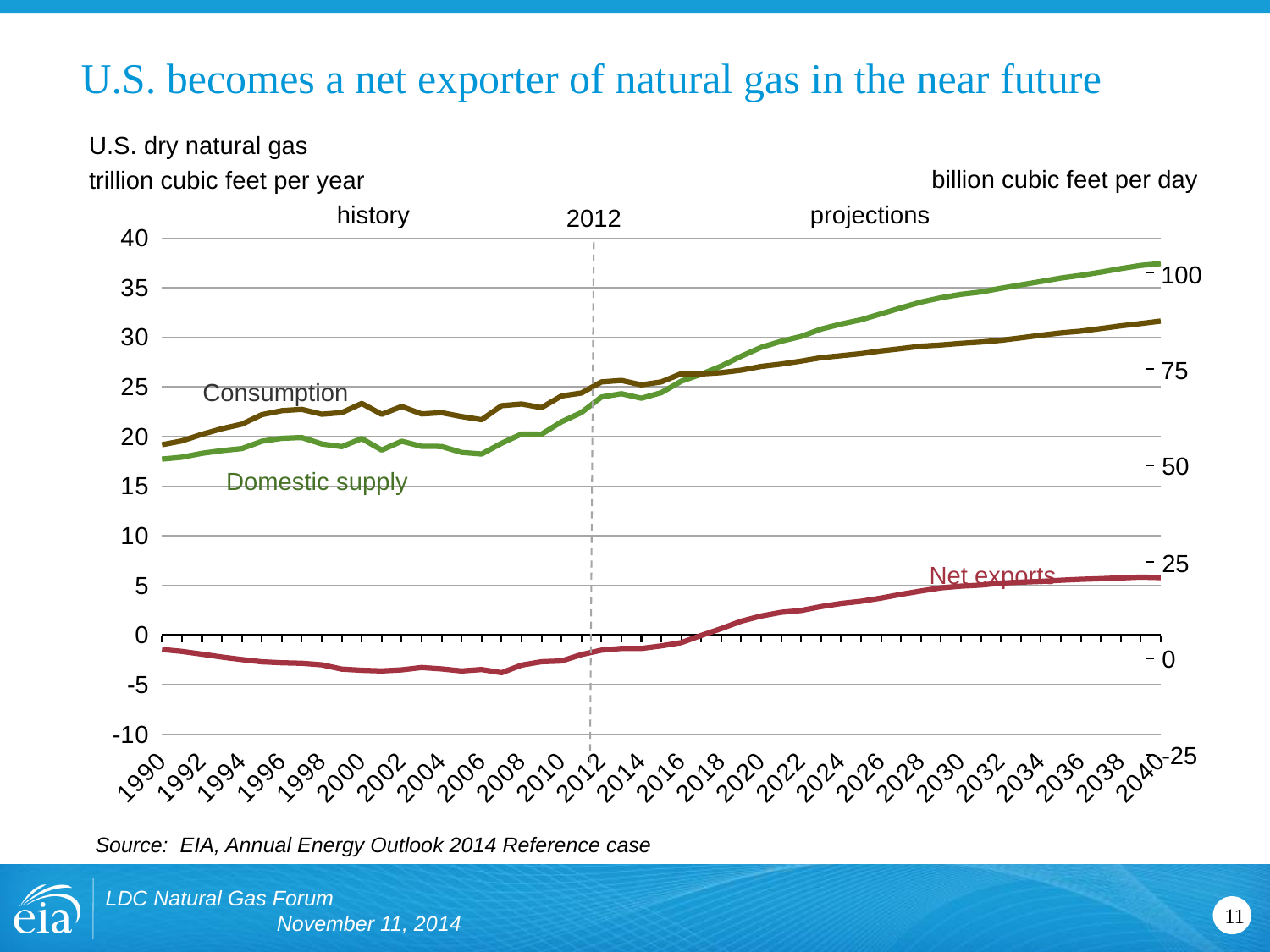
Is the value for Net exports in 2040 greater or less than 10 trillion cubic feet per year? less In 2040, which is larger: Consumption or Domestic supply? Domestic supply Is the value for Domestic supply in 2040 greater or less than 35 trillion cubic feet per year? greater What year does the dashed vertical line separating history from projections mark? 2012 What unit is shown on the left vertical axis of the chart? trillion cubic feet per year Which series has the lowest value in 2040? Net exports Does Domestic supply rise or fall between 2012 and 2040? rise Is the value for Net exports in 1990 greater or less than 0? less Which series has the highest value in 2040? Domestic supply What kind of chart is shown on the slide? line chart In 1990, which is larger: Consumption or Domestic supply? Consumption How many data series are plotted on the chart? 3